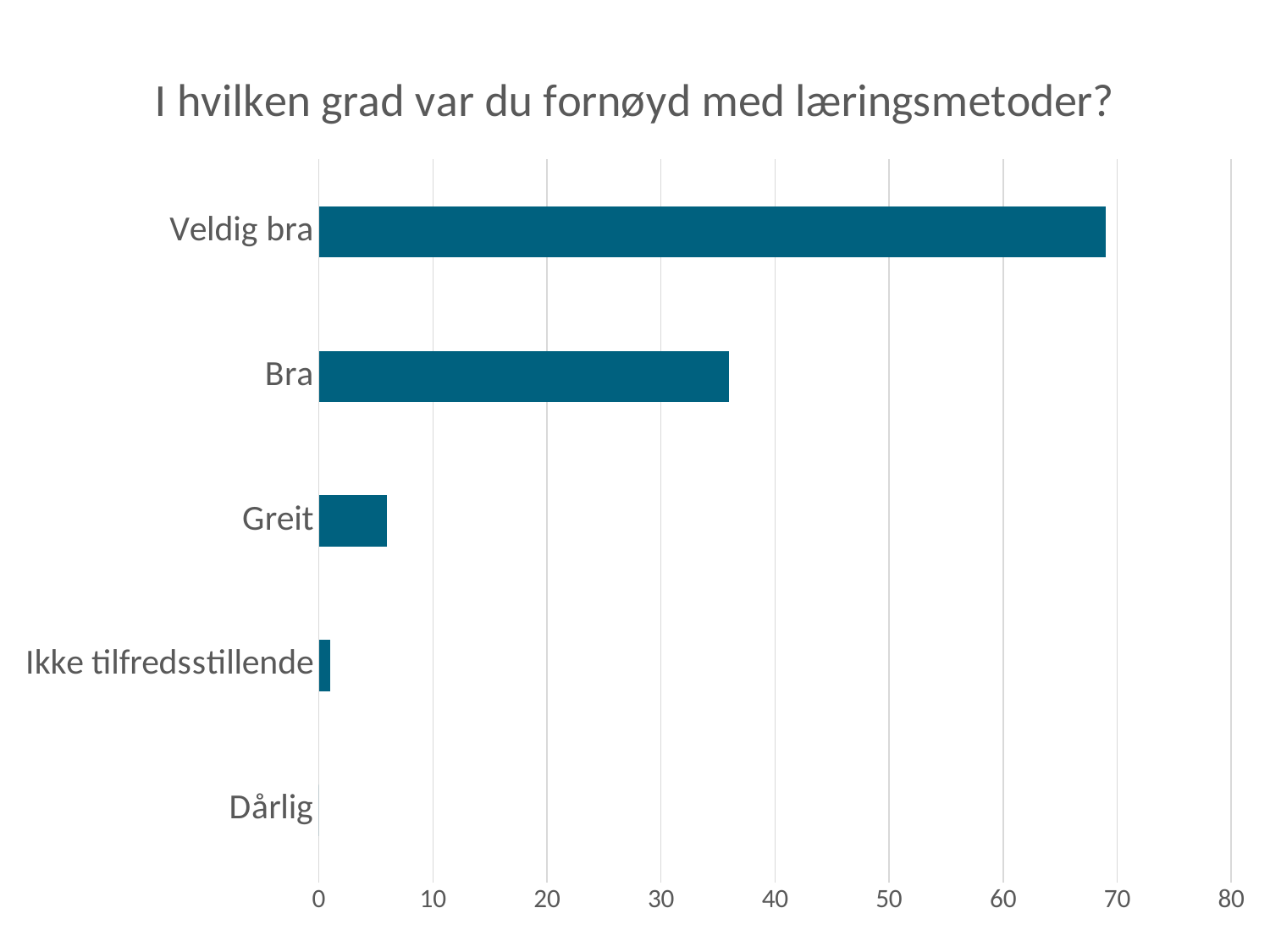
Which is larger, the value for Bra or the value for Greit? Bra Which category has the lowest value? Dårlig What kind of chart is shown on the slide? bar chart Is the value for Greit greater or less than 10? less What is the title of the chart? I hvilken grad var du fornøyd med læringsmetoder? Is the value for Bra greater or less than 30? greater Which is larger, the value for Veldig bra or the value for Bra? Veldig bra Is the value for Veldig bra greater or less than 60? greater How many categories are shown on the chart? 5 Which category has the highest value? Veldig bra What is the highest value shown on the horizontal axis? 80